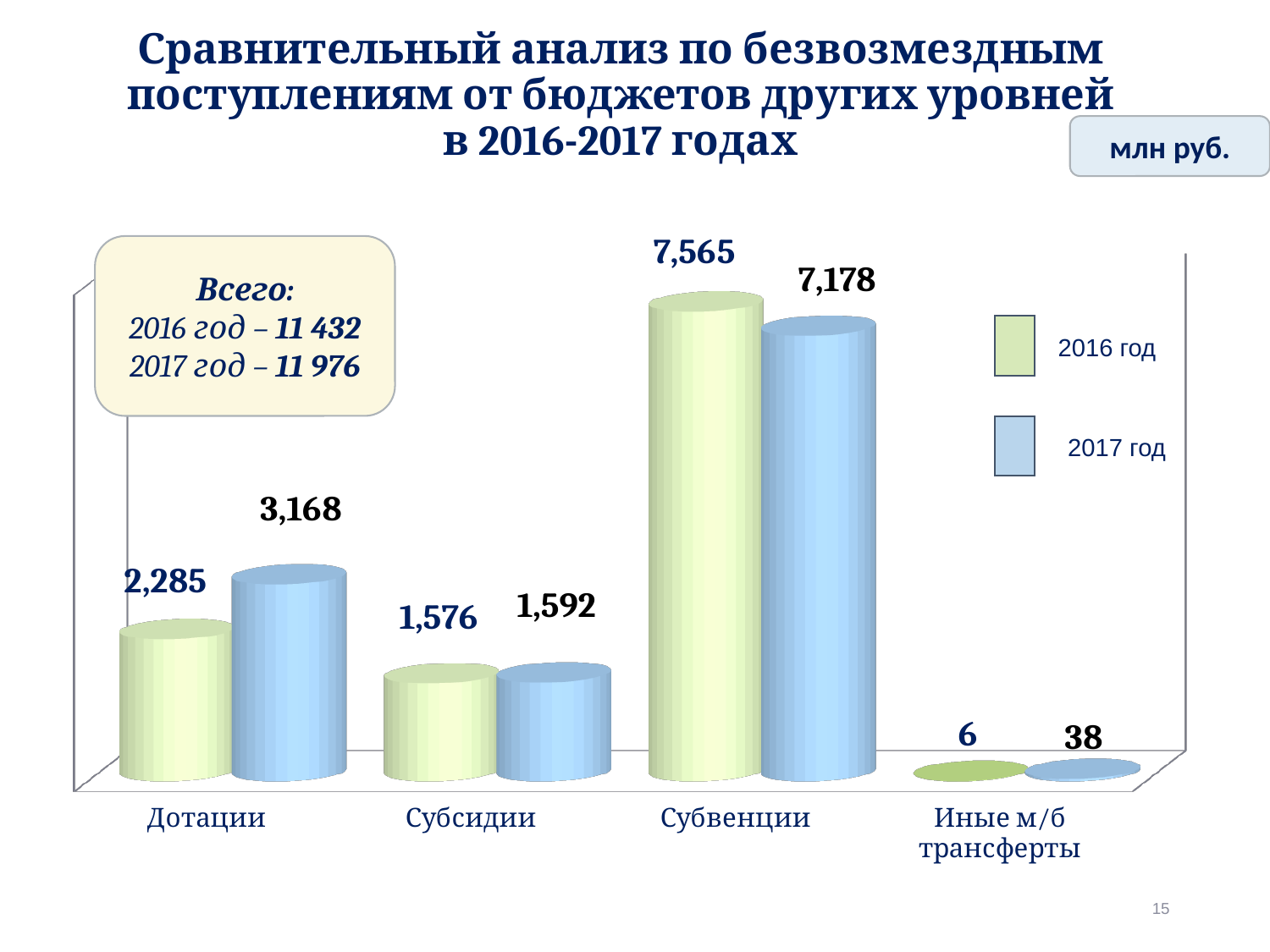
How many series does the legend list? 2 What is the difference between the 2016 год and 2017 год values for Субвенции? 387 What kind of chart is shown on the slide? Bar chart What is the value for Дотации in 2016 год? 2,285 Which category has the lowest value in 2017 год? Иные м/б трансферты Which category has the highest value in 2016 год? Субвенции What is the value for Субсидии in 2016 год? 1,576 What is the difference between the 2017 год and 2016 год values for Дотации? 883 How many categories are shown on the x axis? 4 What is the value for Субвенции in 2017 год? 7,178 Which is larger for Субвенции: the 2016 год value or the 2017 год value? 2016 год What is the value for Иные м/б трансферты in 2017 год? 38